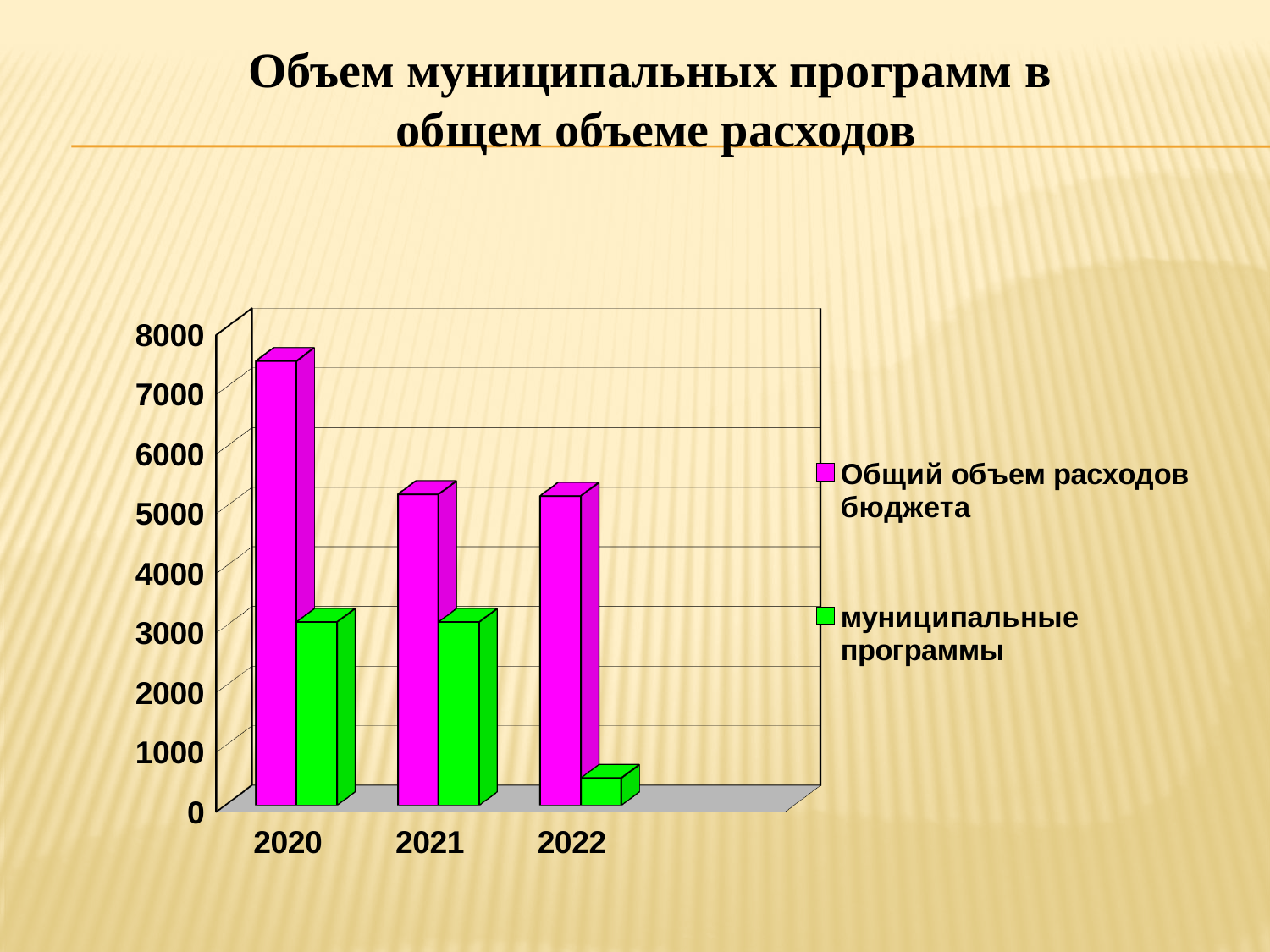
What kind of chart is shown on the slide? bar chart Is the value for "Общий объем расходов бюджета" in 2020 greater or less than 7000? greater Does the value for "Общий объем расходов бюджета" rise or fall from 2020 to 2022? fall What colour are the bars for the "муниципальные программы" series? green Is the value for "муниципальные программы" in 2020 greater or less than 4000? less In which year is the value for "Общий объем расходов бюджета" the highest? 2020 How many years are shown on the x axis of the chart? 3 Is the value for "муниципальные программы" in 2022 greater or less than 1000? less Which is larger: the value for "Общий объем расходов бюджета" in 2020 or in 2021? 2020 How many series does the chart legend list? 2 In which year is the value for "муниципальные программы" the lowest? 2022